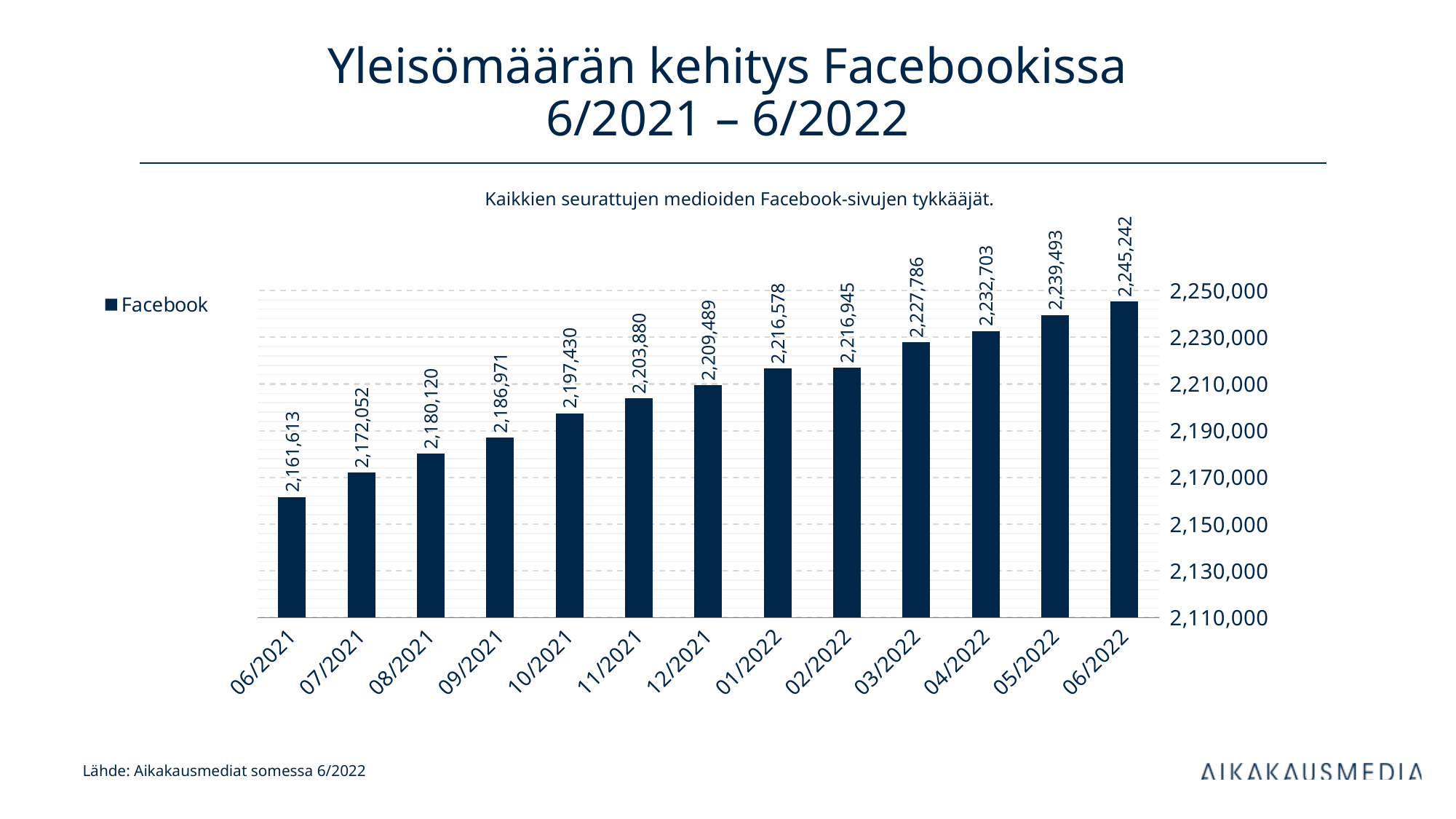
Is the value for 10/2021 greater or less than 2,190,000? greater What is the value for 06/2021? 2,161,613 Do the values rise or fall from 06/2021 to 06/2022? rise What is the difference between the values for 02/2022 and 01/2022? 367 What is the value for 03/2022? 2,227,786 What type of chart is shown on the slide? bar chart How many months are shown on the x axis? 13 What is the value for 12/2021? 2,209,489 Which is larger, the value for 09/2021 or the value for 04/2022? 04/2022 Which month has the highest value? 06/2022 Which month has the lowest value? 06/2021 What is the difference between the values for 06/2022 and 06/2021? 83,629